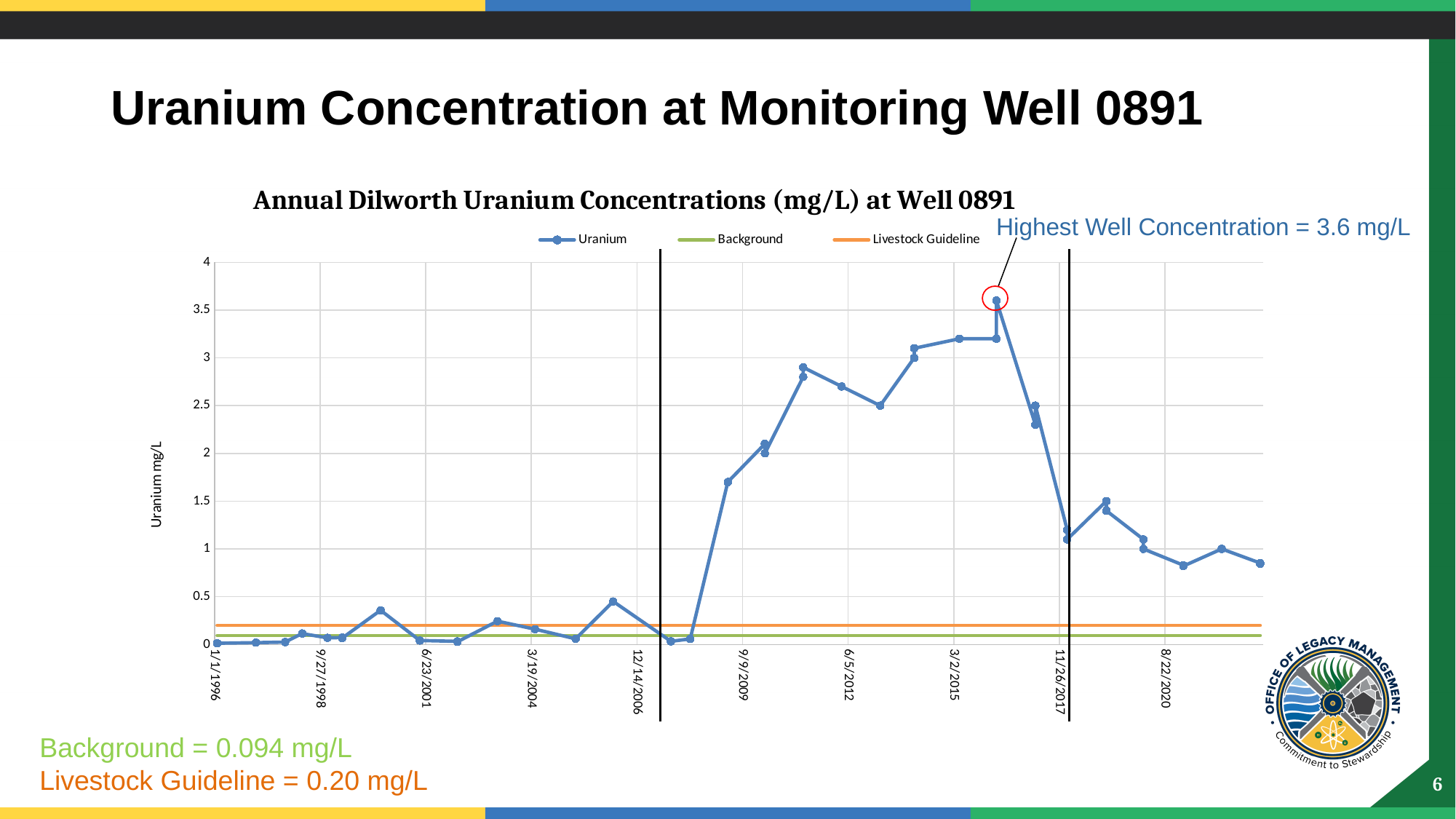
Is the uranium value at 6/5/2012 greater or less than 2.5? greater What is the difference between the Livestock Guideline (0.20 mg/L) and the Background value (0.094 mg/L)? 0.106 mg/L How many series does the chart legend list? 3 What is the highest uranium concentration recorded at Well 0891, as annotated on the slide? 3.6 mg/L What is the Background uranium concentration value stated on the slide? 0.094 mg/L What kind of chart is shown on the slide? Line chart Is the uranium value at 1/1/1996 greater or less than 0.5? less Do the uranium values generally rise or fall between 9/9/2009 and 3/2/2015? Rise What is the Livestock Guideline value stated on the slide? 0.20 mg/L Is the uranium value at 9/9/2009 greater or less than 1.5? greater What is the title of the chart? Annual Dilworth Uranium Concentrations (mg/L) at Well 0891 Which is larger, the Livestock Guideline or the Background value? Livestock Guideline